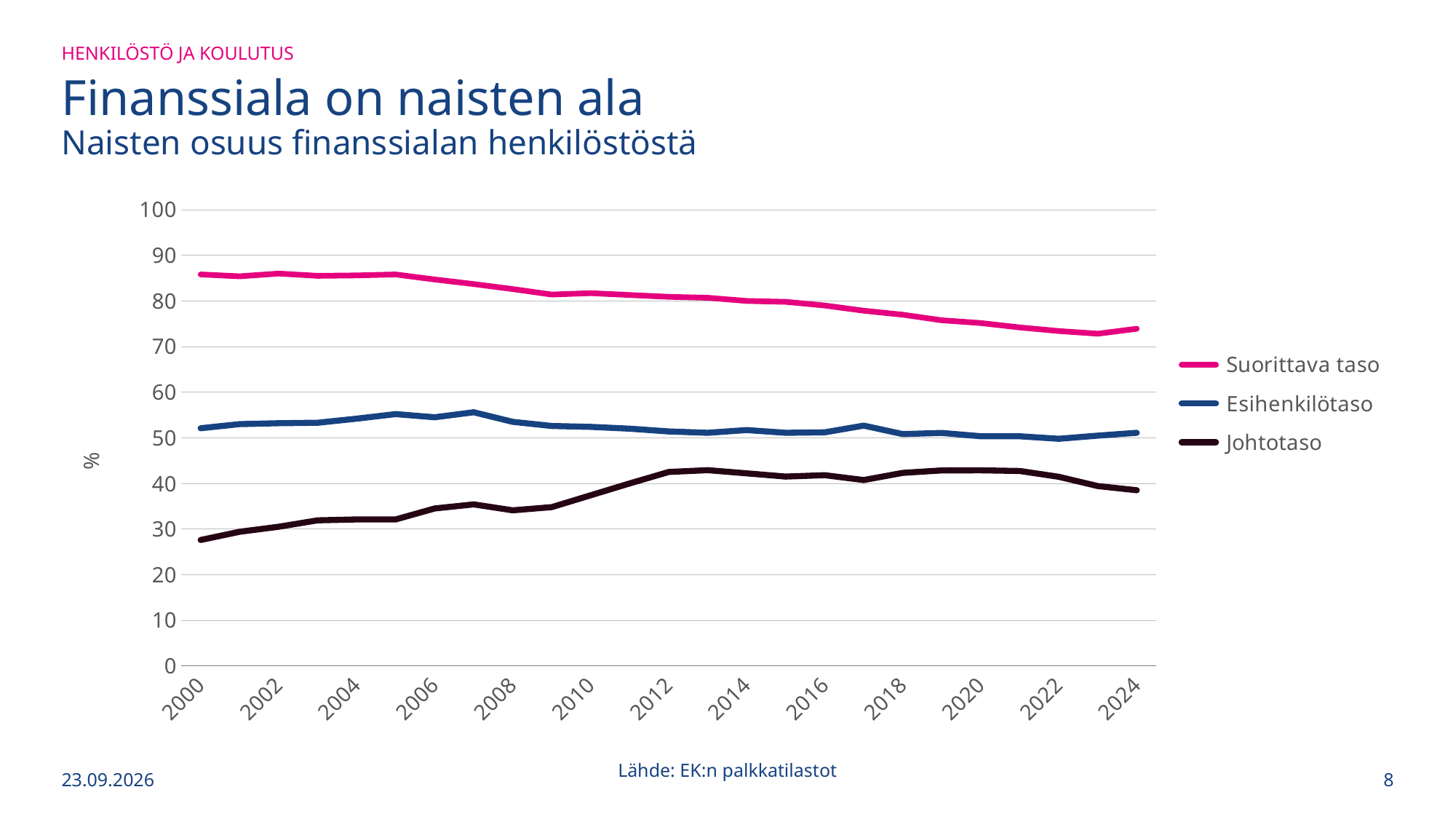
How many series does the legend list? 3 Is the value for Johtotaso in 2000 greater or less than 30? less Is the value for Suorittava taso in 2024 greater or less than 80? less Is the value for Johtotaso in 2012 greater or less than 40? greater Which series is plotted highest across the whole chart? Suorittava taso Does the Suorittava taso line rise or fall from 2000 to 2024? fall What kind of chart is shown on the slide? line chart In 2010, which is larger: the value for Esihenkilötaso or the value for Johtotaso? Esihenkilötaso Does the Johtotaso line rise or fall overall from 2000 to 2024? rise Which series is plotted lowest across the whole chart? Johtotaso What is the subtitle of the chart shown below the main title? Naisten osuus finanssialan henkilöstöstä